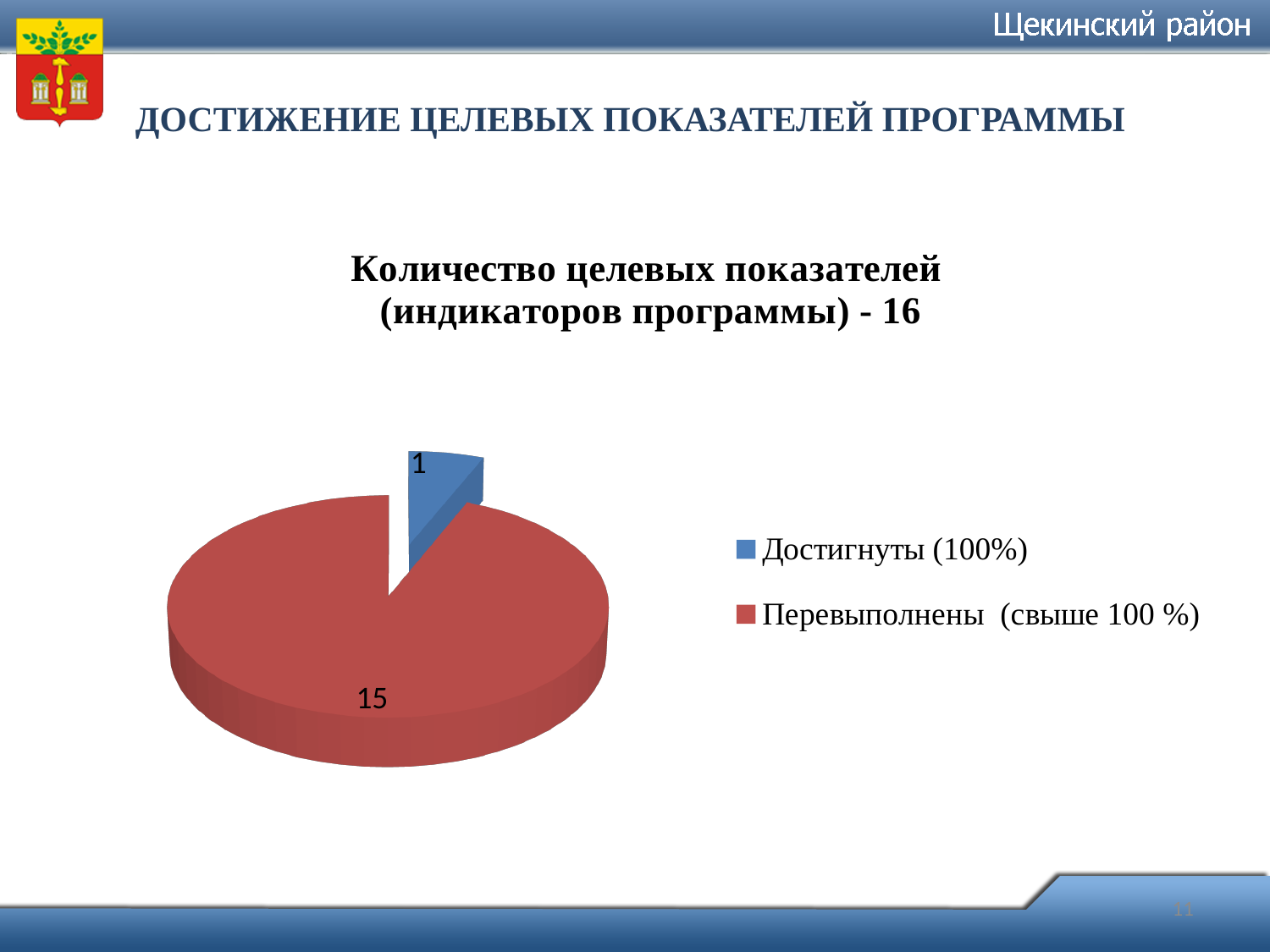
Which category has the largest slice of the pie? Перевыполнены (свыше 100 %) What is the value for "Перевыполнены (свыше 100 %)"? 15 What is the difference between the values for "Перевыполнены (свыше 100 %)" and "Достигнуты (100%)"? 14 What is the value for "Достигнуты (100%)"? 1 What colour is the slice for "Достигнуты (100%)"? blue How many entries does the legend list? 2 How many slices does the pie chart have? 2 Which is larger: the value for "Достигнуты (100%)" or the value for "Перевыполнены (свыше 100 %)"? Перевыполнены (свыше 100 %) What is the title of the chart? Количество целевых показателей (индикаторов программы) - 16 What kind of chart is shown on the slide? pie chart Which category has the smallest slice of the pie? Достигнуты (100%) What is the total of the two slices in the pie chart? 16